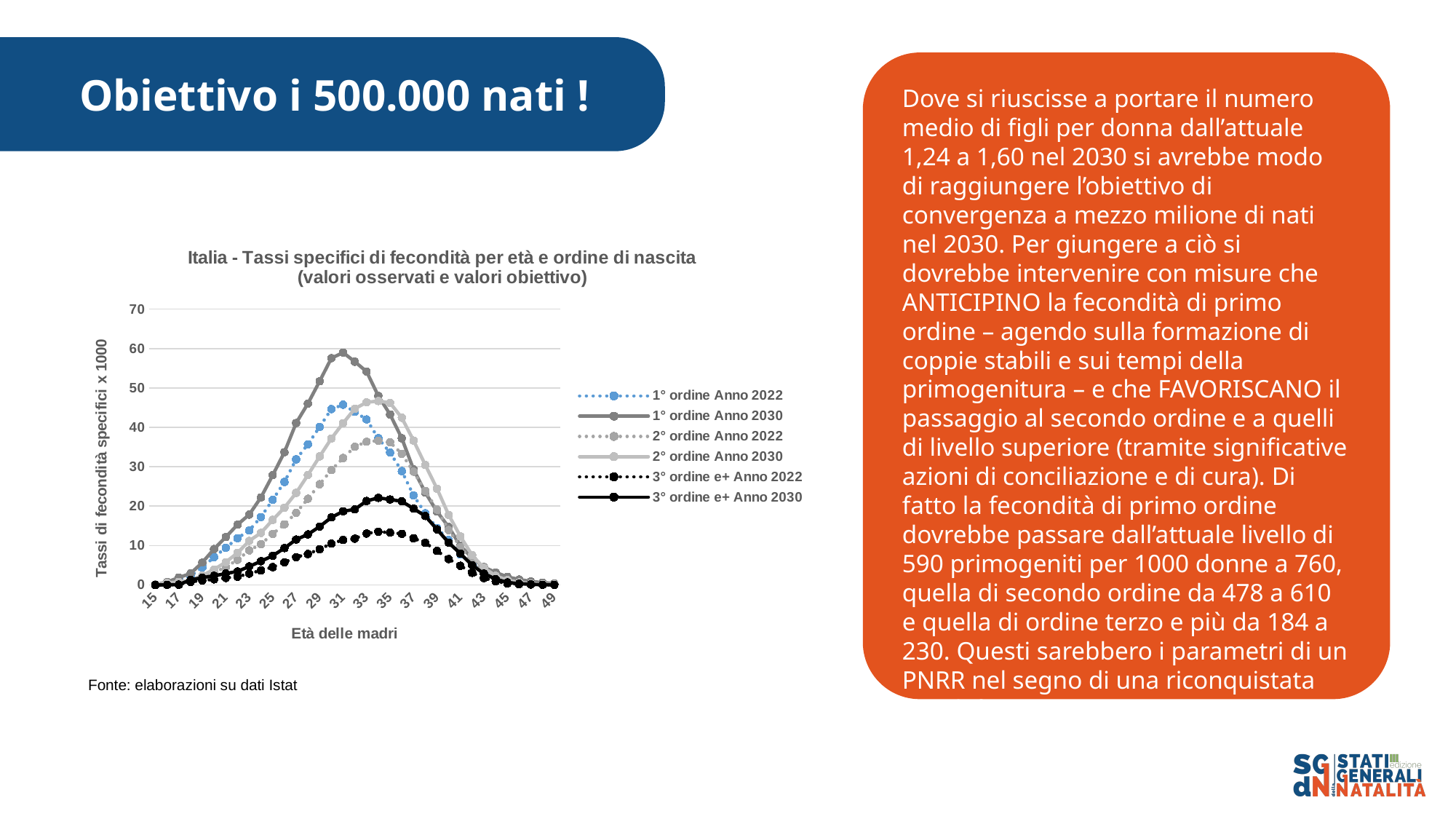
What is the title of the chart? Italia - Tassi specifici di fecondità per età e ordine di nascita (valori osservati e valori obiettivo) How many series does the chart legend list? 6 At age 31, which is larger: the value for 1° ordine Anno 2030 or for 1° ordine Anno 2022? 1° ordine Anno 2030 Is the peak value of the 3° ordine e+ Anno 2030 series greater or less than 30? less What is the highest value shown on the y axis of the chart? 70 Is the peak value of the 1° ordine Anno 2030 series greater or less than 50? greater Is the peak value of the 2° ordine Anno 2030 series greater or less than 40? greater Which series reaches the highest peak value in the chart? 1° ordine Anno 2030 Which series has the lowest peak value in the chart? 3° ordine e+ Anno 2022 What is the label of the x axis of the chart? Età delle madri What kind of chart is shown on the slide? line chart